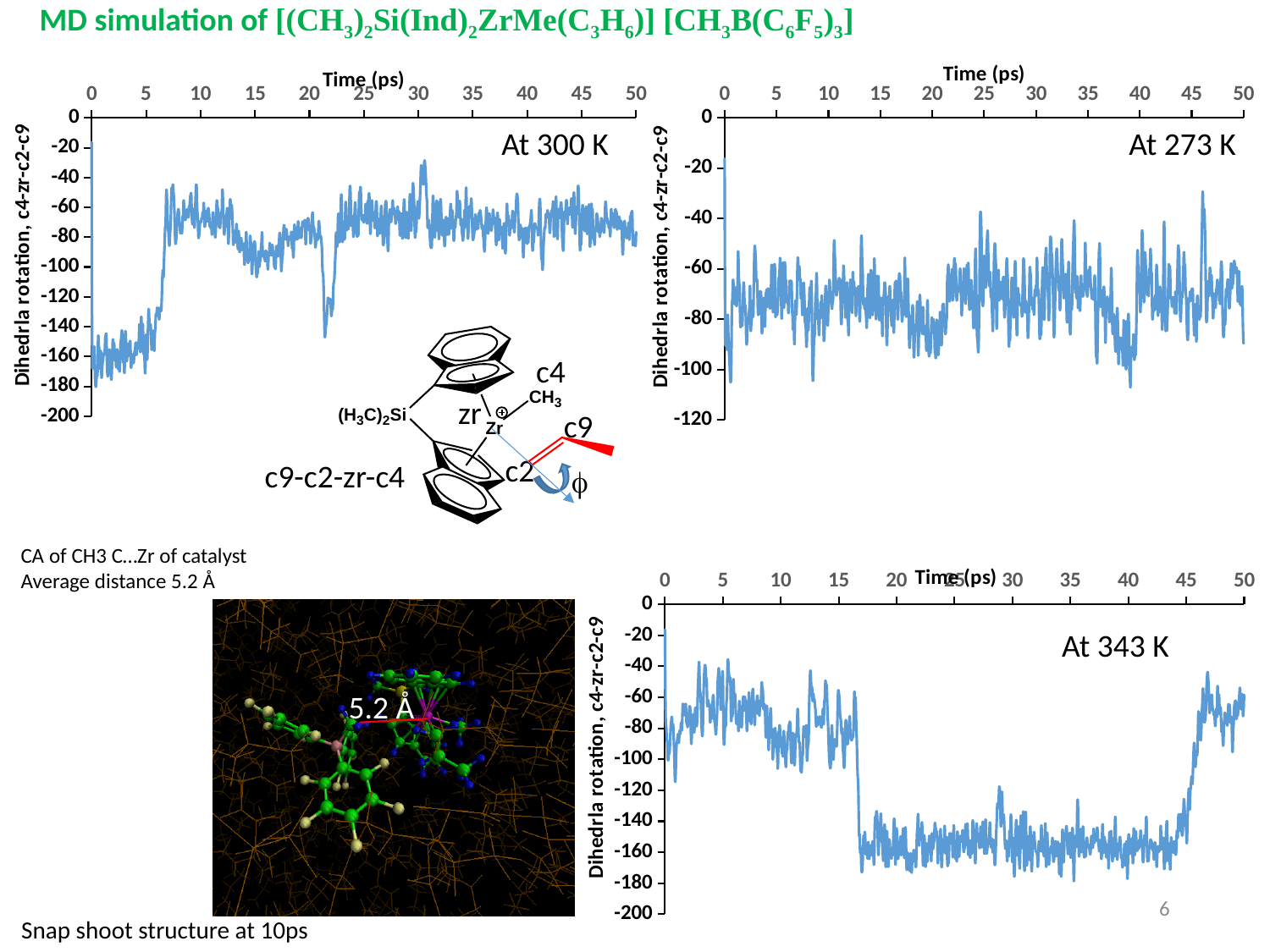
What kind of chart is the 'At 300 K' chart? line chart On the 'At 343 K' chart, does the dihedral rotation rise or fall between 44 ps and 47 ps? rise How many dihedral rotation charts are shown on the slide? 3 On the 'At 300 K' chart, is the dihedral rotation value at 10 ps greater or less than -100? greater On the 'At 343 K' chart, does the dihedral rotation rise or fall between 15 ps and 20 ps? fall On the 'At 343 K' chart, is the dihedral rotation value at 30 ps greater or less than -120? less What is the lowest y-axis tick value shown on the 'At 273 K' chart? -120 On the 'At 343 K' chart, is the dihedral rotation value at 5 ps greater or less than -100? greater What is the x-axis title of the 'At 273 K' chart? Time (ps) On the 'At 300 K' chart, does the dihedral rotation rise or fall between 5 ps and 8 ps? rise